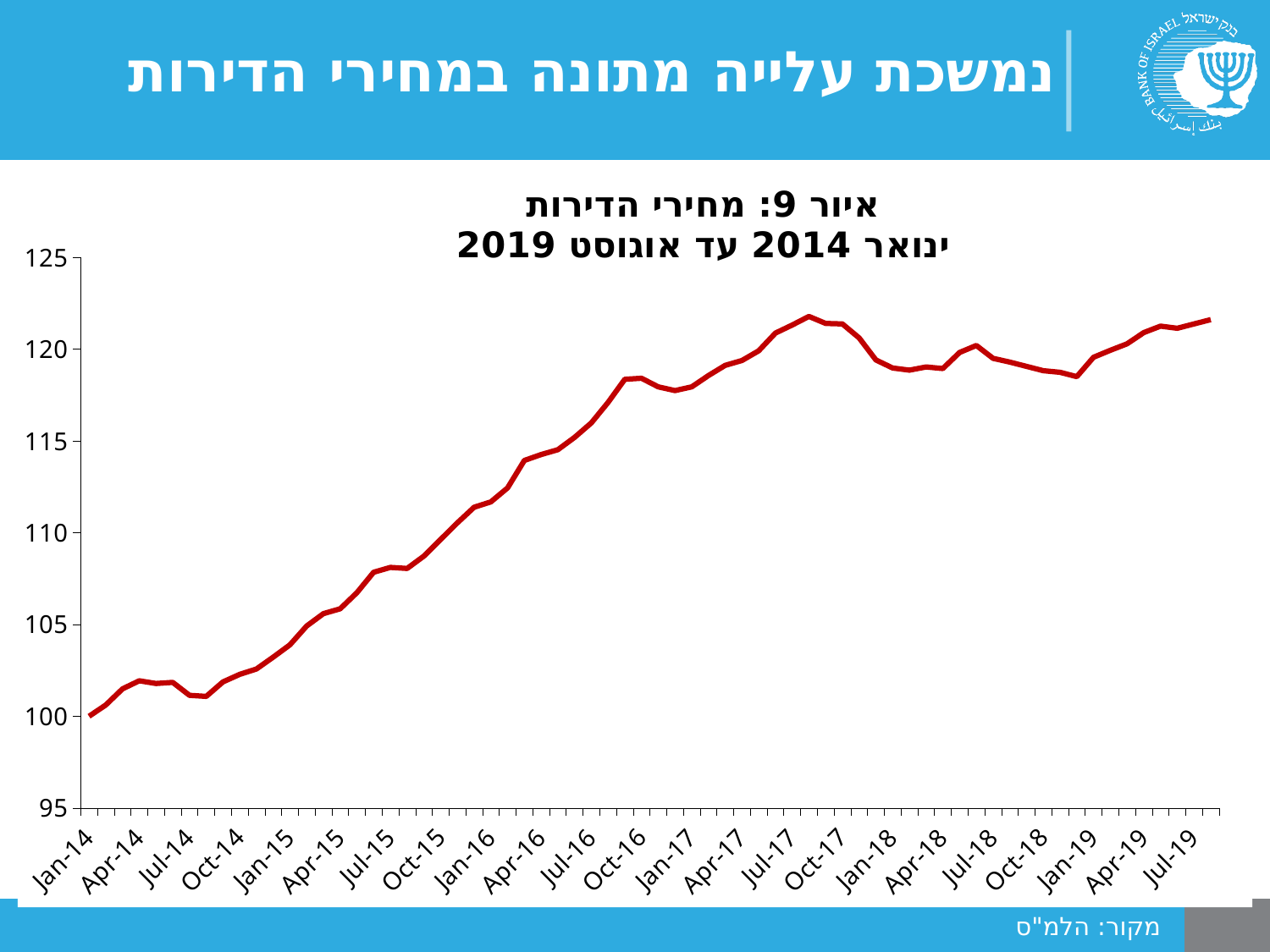
Overall, do the values rise or fall from Jan-14 to Jul-19? rise At which point on the x axis is the index lowest? Jan-14 Which is larger, the value at Jul-19 or the value at Jan-14? Jul-19 Is the value for Jan-15 greater or less than 105? less Is the value for Jan-16 greater or less than 110? greater Is the value for Jan-19 greater or less than 120? less What is the title of the chart? איור 9: מחירי הדירות ינואר 2014 עד אוגוסט 2019 What is the value of the index at Jan-14? 100 What kind of chart is shown on the slide? line chart